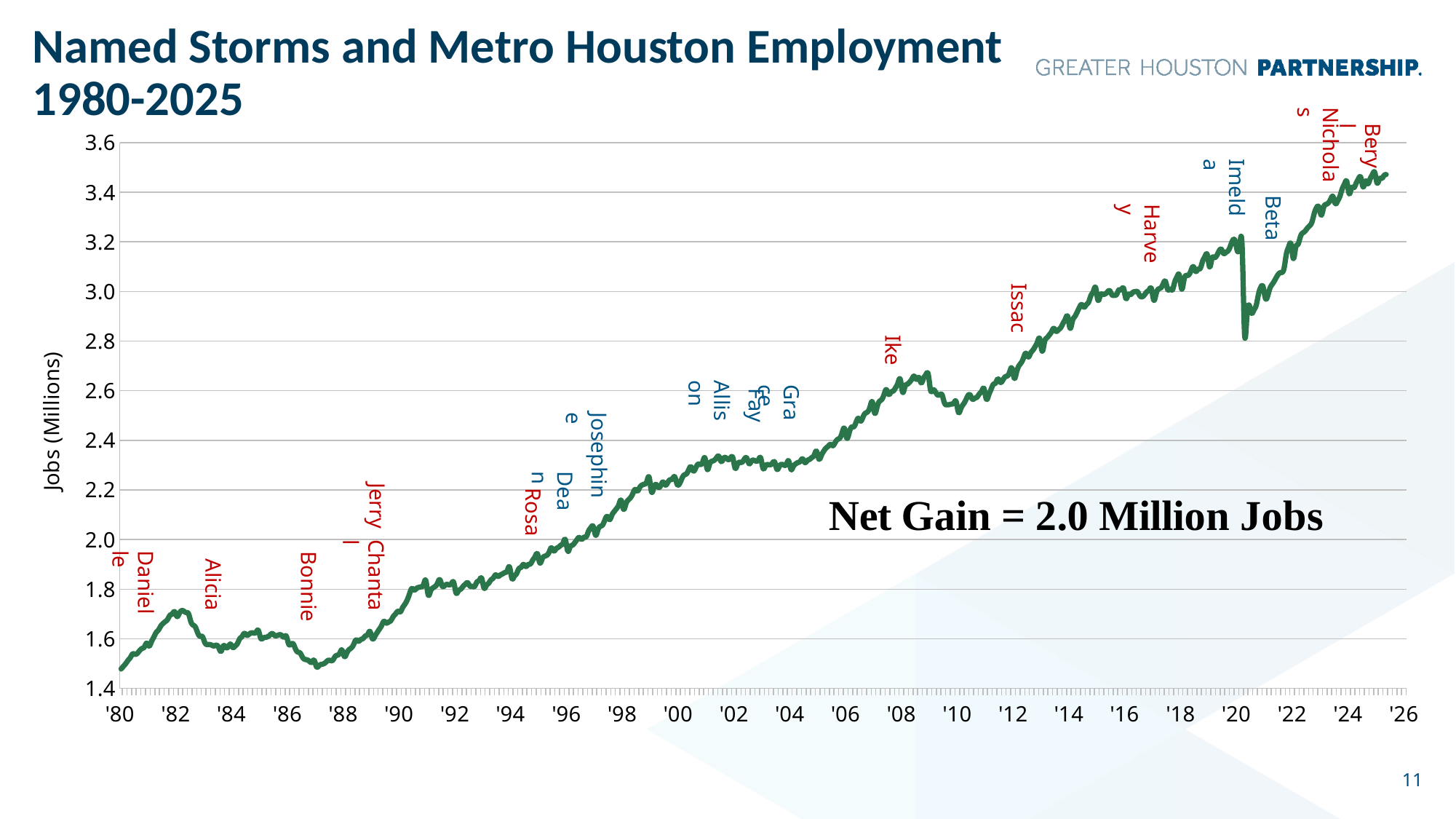
What is the label on the vertical axis? Jobs (Millions) Is the value for jobs at the 2020 dip greater or less than 3.0 million? less Is the value for jobs in 2010 greater or less than 2.6 million? less What net gain in jobs does the chart annotation state? 2.0 Million Jobs Is the value for jobs in 2000 greater or less than 2.2 million? greater Which is larger, the jobs value in 1982 or the jobs value in 1987? 1982 What kind of chart is shown on the slide? line chart What is the title of the chart? Named Storms and Metro Houston Employment 1980-2025 Overall, do Metro Houston jobs rise or fall from 1980 to 2025? rise